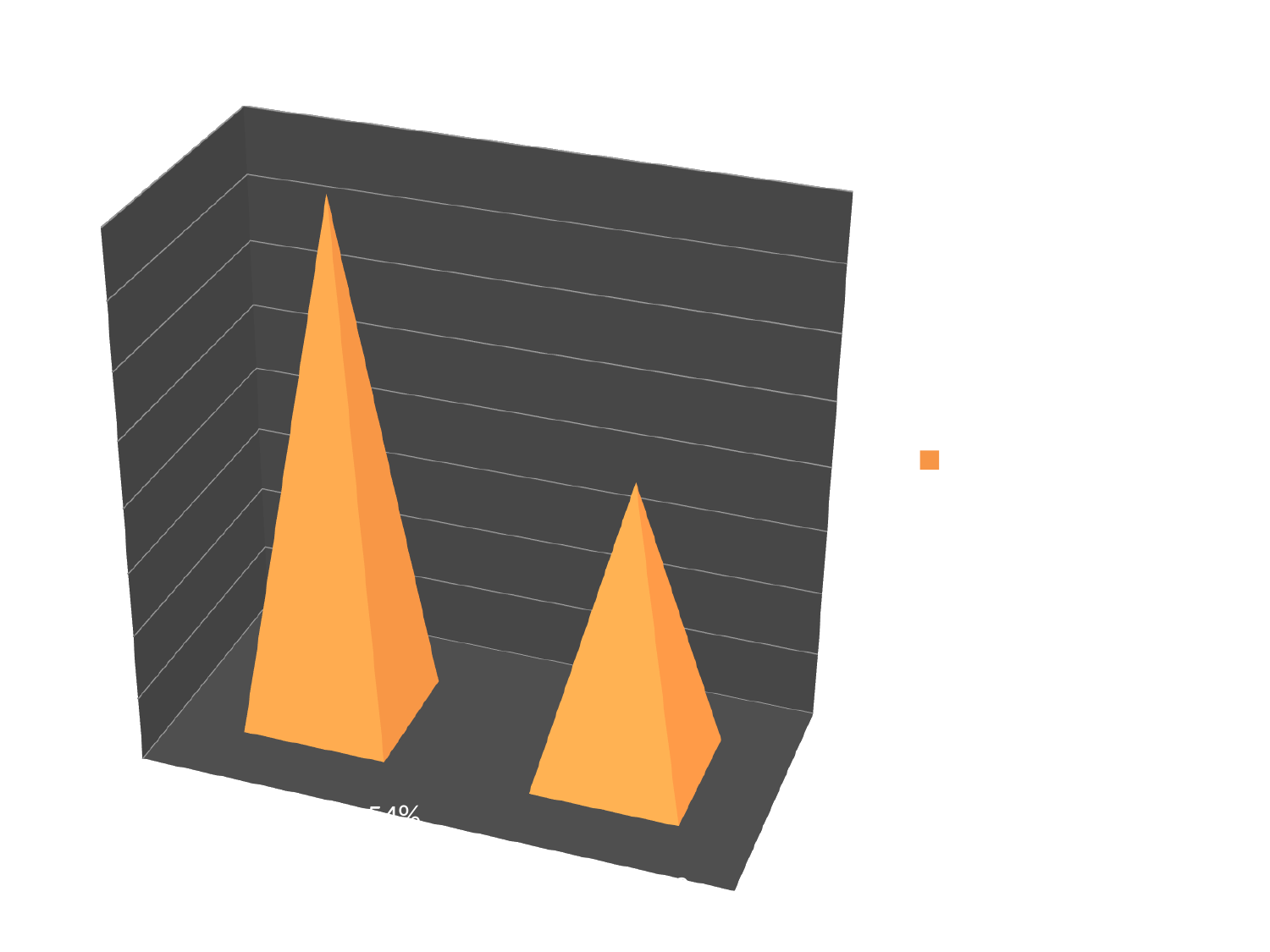
How many series does the legend list? 1 What colour are the bars in the chart? orange Do the values fall or rise from the left bar to the right bar? fall Which bar has the lowest value, the left one or the right one? the right one What kind of chart is shown on the slide? bar chart Which bar is taller, the left one or the right one? the left one How many bars are plotted in the chart? 2